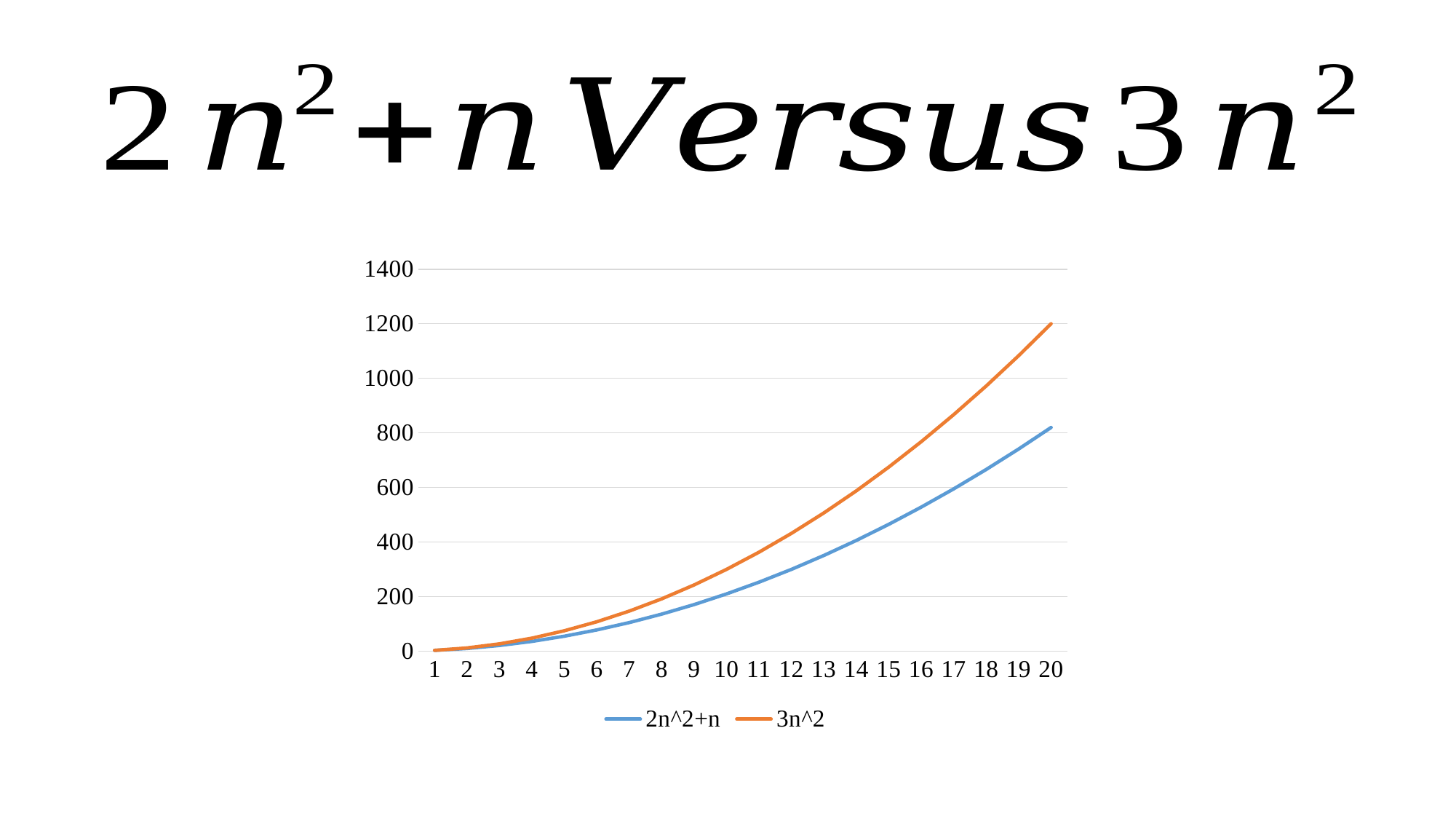
What kind of chart is shown on the slide? Line chart Is the value of the 2n^2+n series at n = 15 greater or less than 400? greater Is the value of the 3n^2 series at n = 15 greater or less than 600? greater Do the values of the 2n^2+n series rise or fall along the x axis? Rise At n = 20, which series has the larger value, 2n^2+n or 3n^2? 3n^2 Do the values of the 3n^2 series rise or fall as n increases from 1 to 20? Rise What is the highest value shown on the vertical axis? 1400 Which series is drawn in orange? 3n^2 How many points along the x axis does each line cover? 20 How many series does the legend list? 2 Is the value of the 2n^2+n series at n = 20 greater or less than 1000? less What value does the 3n^2 series reach at n = 20? 1200